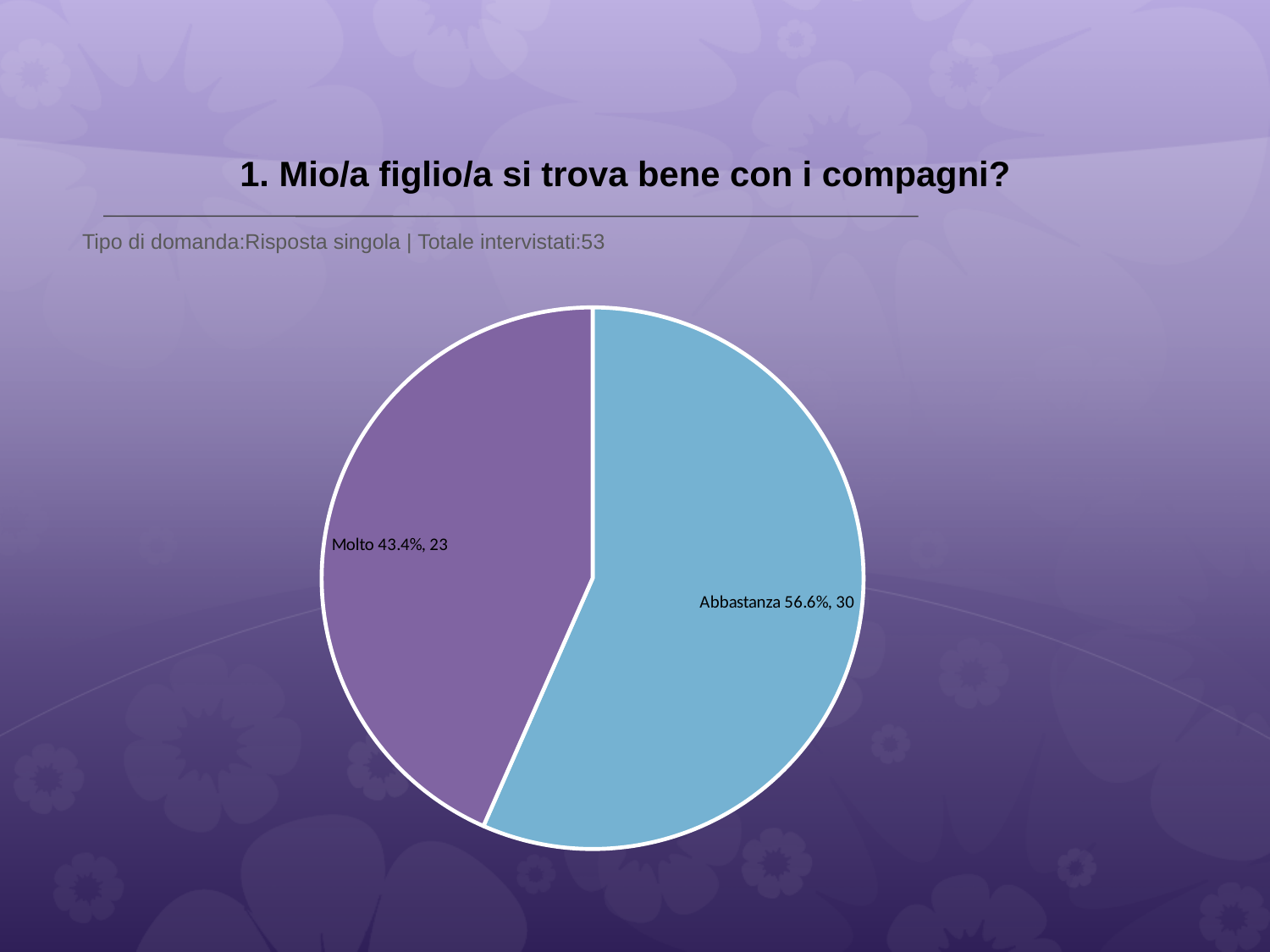
Which response has the largest slice? Abbastanza What percentage share does the Abbastanza slice have? 56.6% What kind of chart is shown on the slide? pie chart Which response has the smallest slice? Molto How many respondents answered Abbastanza? 30 What is the difference in respondent count between Abbastanza and Molto? 7 Which is larger, the Molto slice or the Abbastanza slice? Abbastanza How many slices does the pie chart have? 2 What colour is the Abbastanza slice? blue What percentage share does the Molto slice have? 43.4% What is the total number of respondents across both slices? 53 How many respondents answered Molto? 23